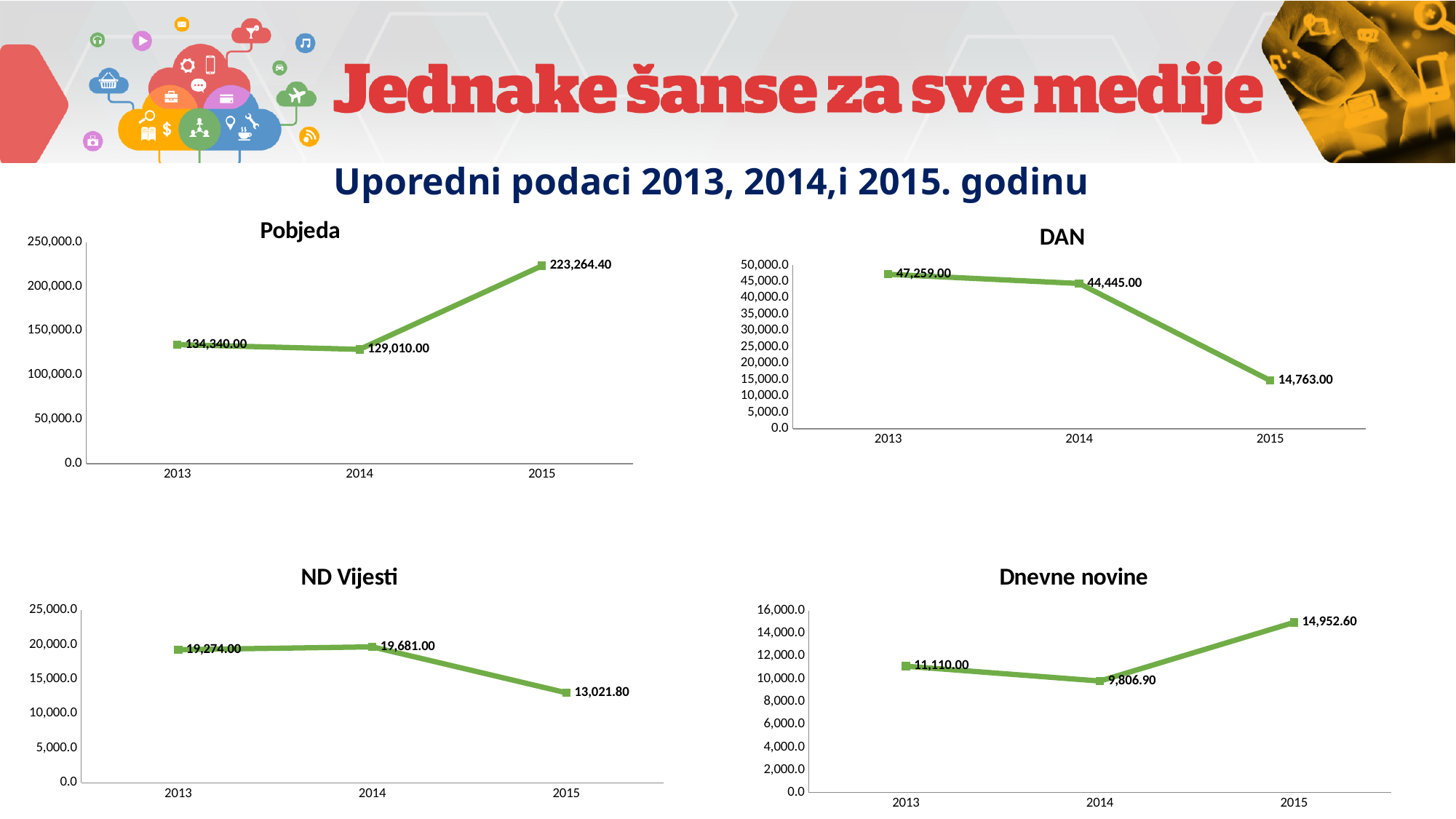
In the DAN chart, do the values rise or fall from 2013 to 2015? fall In the DAN chart, which year has the lowest value? 2015 In the Pobjeda chart, what is the value for 2015? 223,264.40 In the ND Vijesti chart, how many data points are plotted? 3 What type of chart is the DAN chart? line chart In the Dnevne novine chart, what is the value for 2014? 9,806.90 In the Pobjeda chart, what is the difference between the 2015 and 2014 values? 94,254.40 In the DAN chart, by how much did the value fall from 2013 to 2015? 32,496.00 In the Pobjeda chart, which year has the highest value? 2015 In the Dnevne novine chart, is the value for 2013 larger or smaller than the value for 2015? smaller In the ND Vijesti chart, what is the value for 2014? 19,681.00 In the DAN chart, what is the value for 2013? 47,259.00